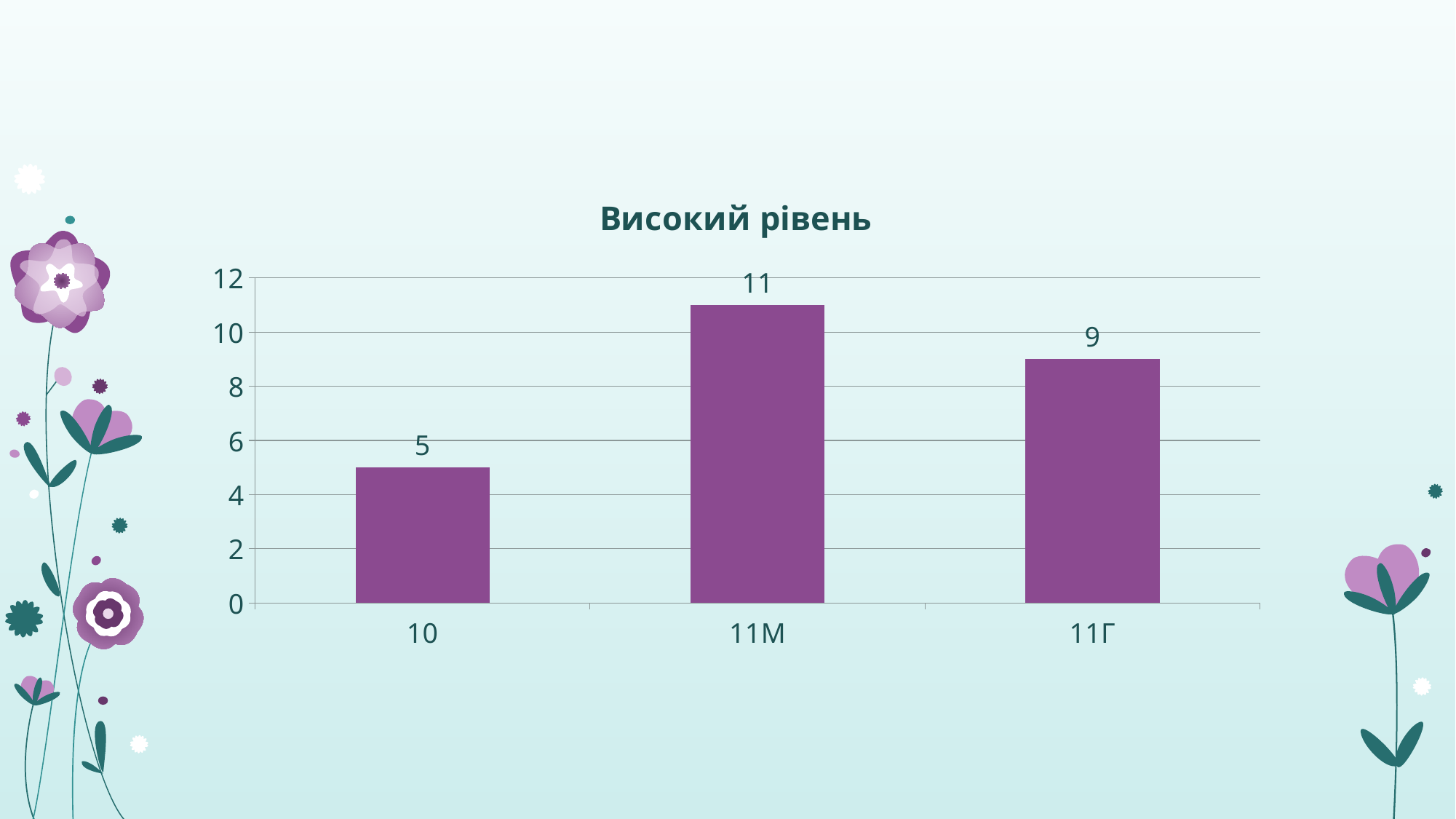
What is the title of the chart? Високий рівень What kind of chart is shown on the slide? bar chart What is the difference between the values for 11М and 11Г? 2 Which category has the highest value? 11М Which is larger, the value for 11Г or the value for 10? 11Г Which category has the lowest value? 10 What is the value for category 10? 5 What is the value for category 11М? 11 Is the value for 11Г greater or less than 8? greater What is the difference between the values for 11М and 10? 6 How many categories are shown on the x axis? 3 What is the value for category 11Г? 9